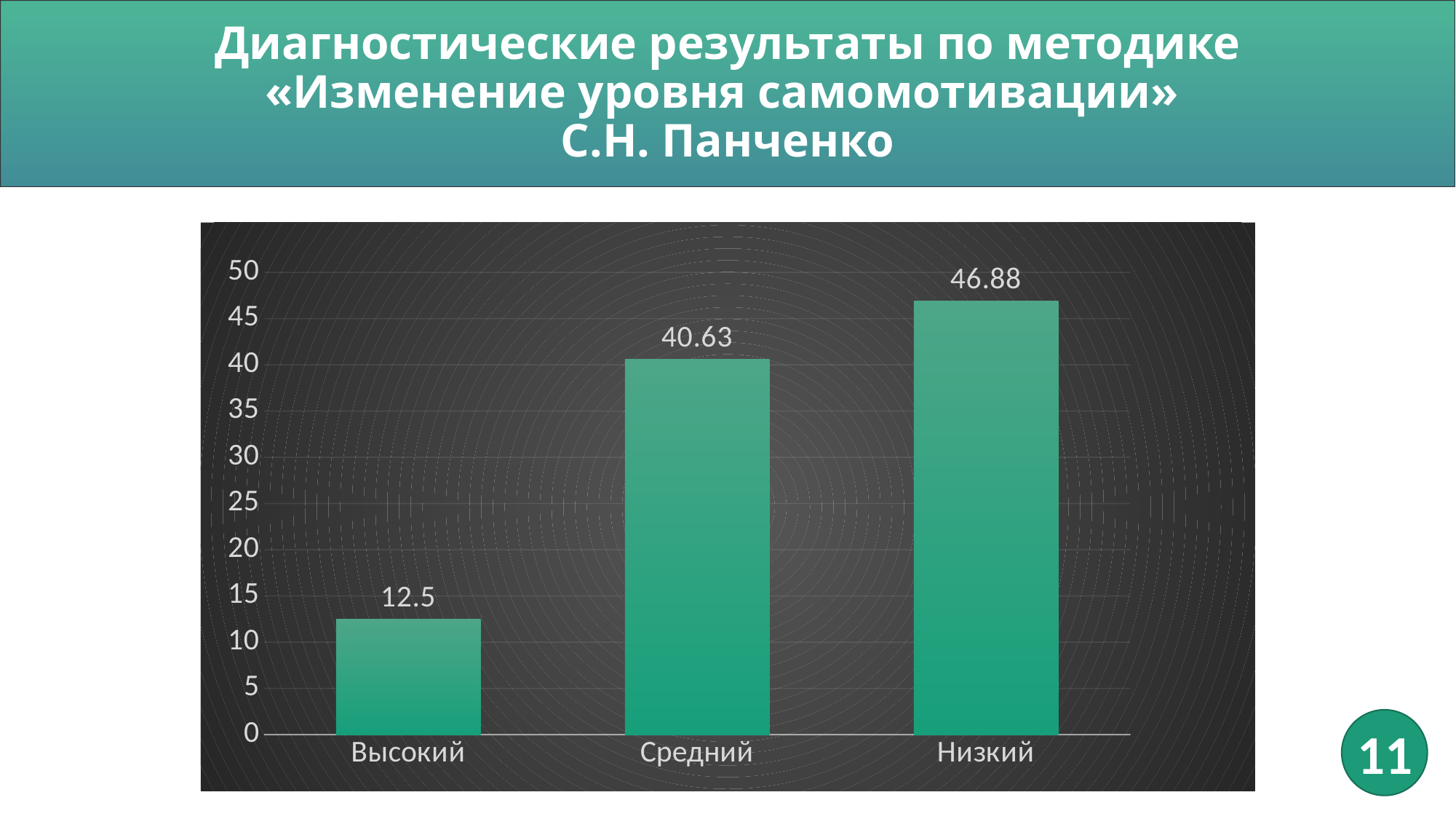
What is the value for Низкий? 46.88 Which is larger, the value for Высокий or the value for Средний? Средний What is the difference between the values for Низкий and Средний? 6.25 Which category has the lowest value? Высокий What is the value for Высокий? 12.5 What is the difference between the values for Средний and Высокий? 28.13 What kind of chart is shown on the slide? bar chart Which category has the highest value? Низкий Is the value for Низкий greater or less than 45? greater Do the values rise or fall from left to right along the x axis? rise What is the value for Средний? 40.63 How many categories are shown on the x axis? 3